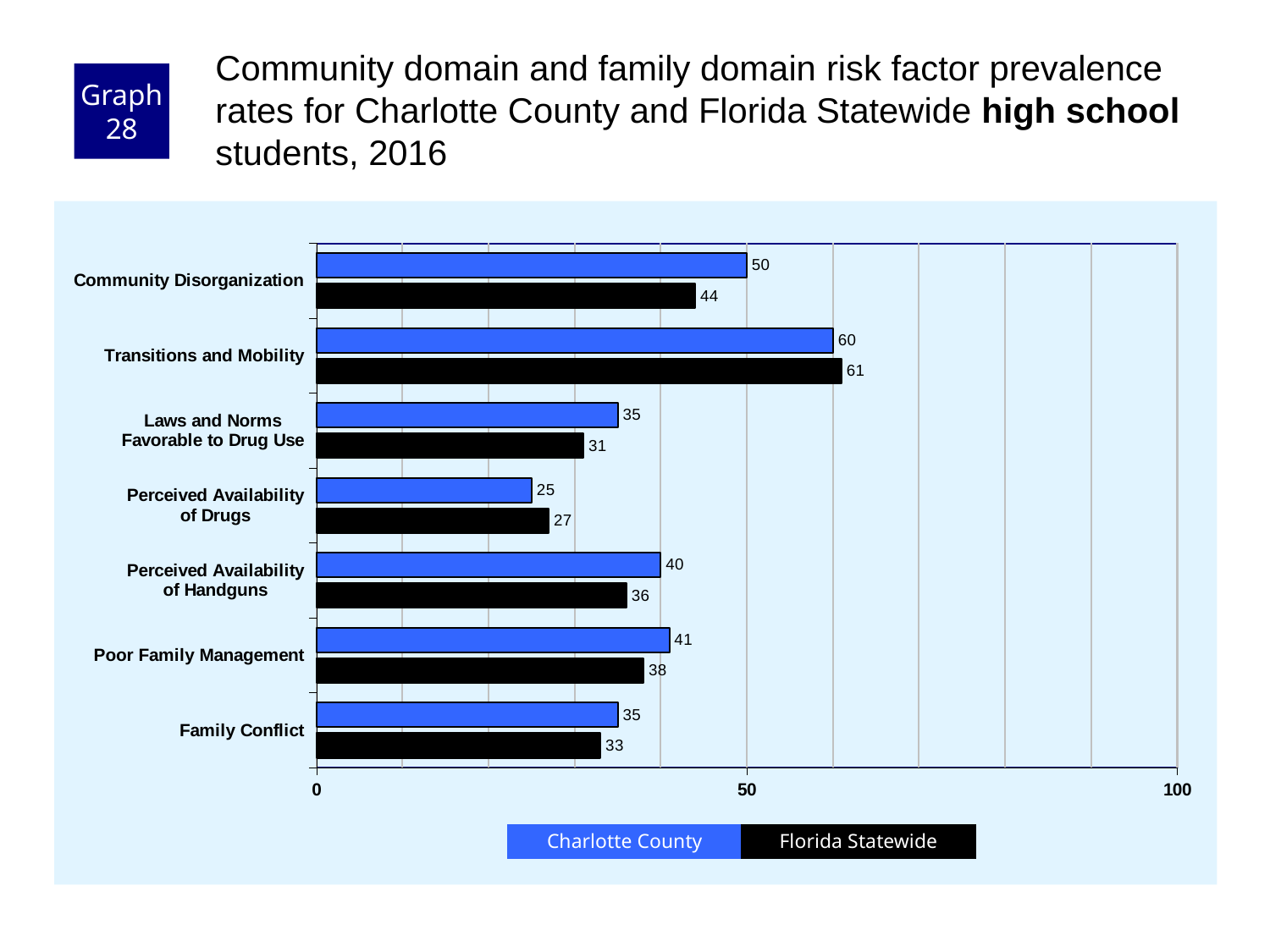
Which risk factor has the highest Charlotte County value? Transitions and Mobility Which is larger for Perceived Availability of Drugs: the Charlotte County value or the Florida Statewide value? Florida Statewide Is the Charlotte County value for Poor Family Management greater or less than 50? less What is the Florida Statewide value for Transitions and Mobility? 61 How many series does the legend list? 2 What is the Charlotte County value for Community Disorganization? 50 What is the Florida Statewide value for Perceived Availability of Drugs? 27 How many risk factor categories are shown on the chart? 7 What is the difference between the Charlotte County and Florida Statewide values for Community Disorganization? 6 Which risk factor has the lowest Florida Statewide value? Perceived Availability of Drugs Which colour represents Florida Statewide in the chart? black What kind of chart is shown on the slide? bar chart